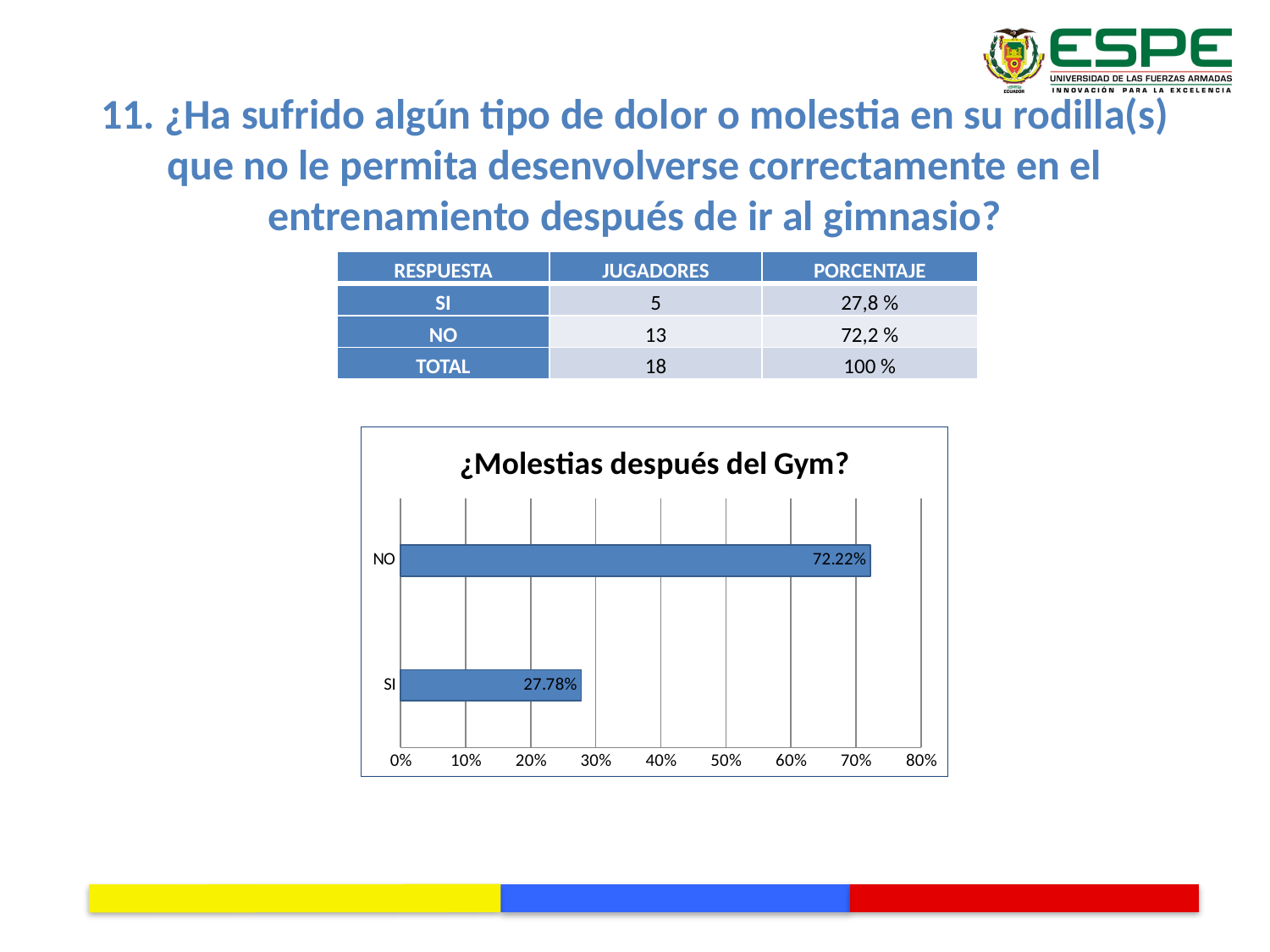
Which category has the highest value in the chart? NO Is the value for NO greater or less than 70%? greater What is the value for NO in the chart? 72.22% Is the value for SI greater or less than 30%? less How many categories are shown in the chart? 2 What is the value for SI in the chart? 27.78% What is the title of the chart? ¿Molestias después del Gym? What is the difference between the values for NO and SI in the chart? 44.44% Which is larger in the chart, the value for SI or the value for NO? NO What kind of chart is shown on the slide? bar chart What is the highest value shown on the chart's horizontal axis? 80% Which category has the lowest value in the chart? SI